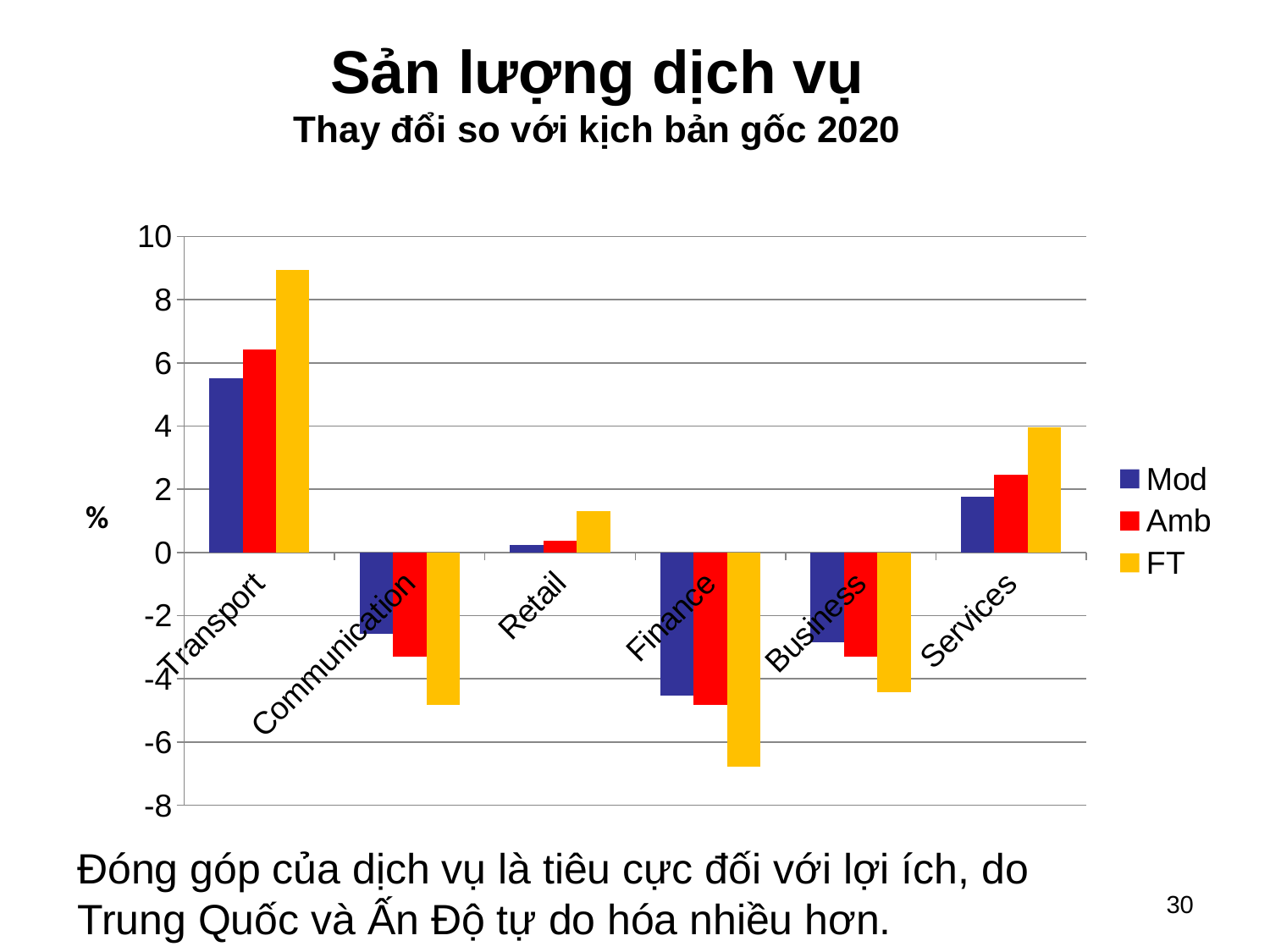
Which category has the highest FT value? Transport Which is larger, the FT value for Transport or the FT value for Services? Transport How many categories are shown on the x axis? 6 Is the Amb value for Services greater or less than 2? greater Is the FT value for Transport greater or less than 8? greater What are the three legend entries of the chart? Mod, Amb, FT Is the Mod value for Finance greater or less than -4? less Which is lower, the FT value for Finance or the FT value for Communication? Finance How many series does the legend list? 3 What kind of chart is shown on the slide? bar chart Which category has the highest Mod value? Transport Which category has the lowest FT value? Finance